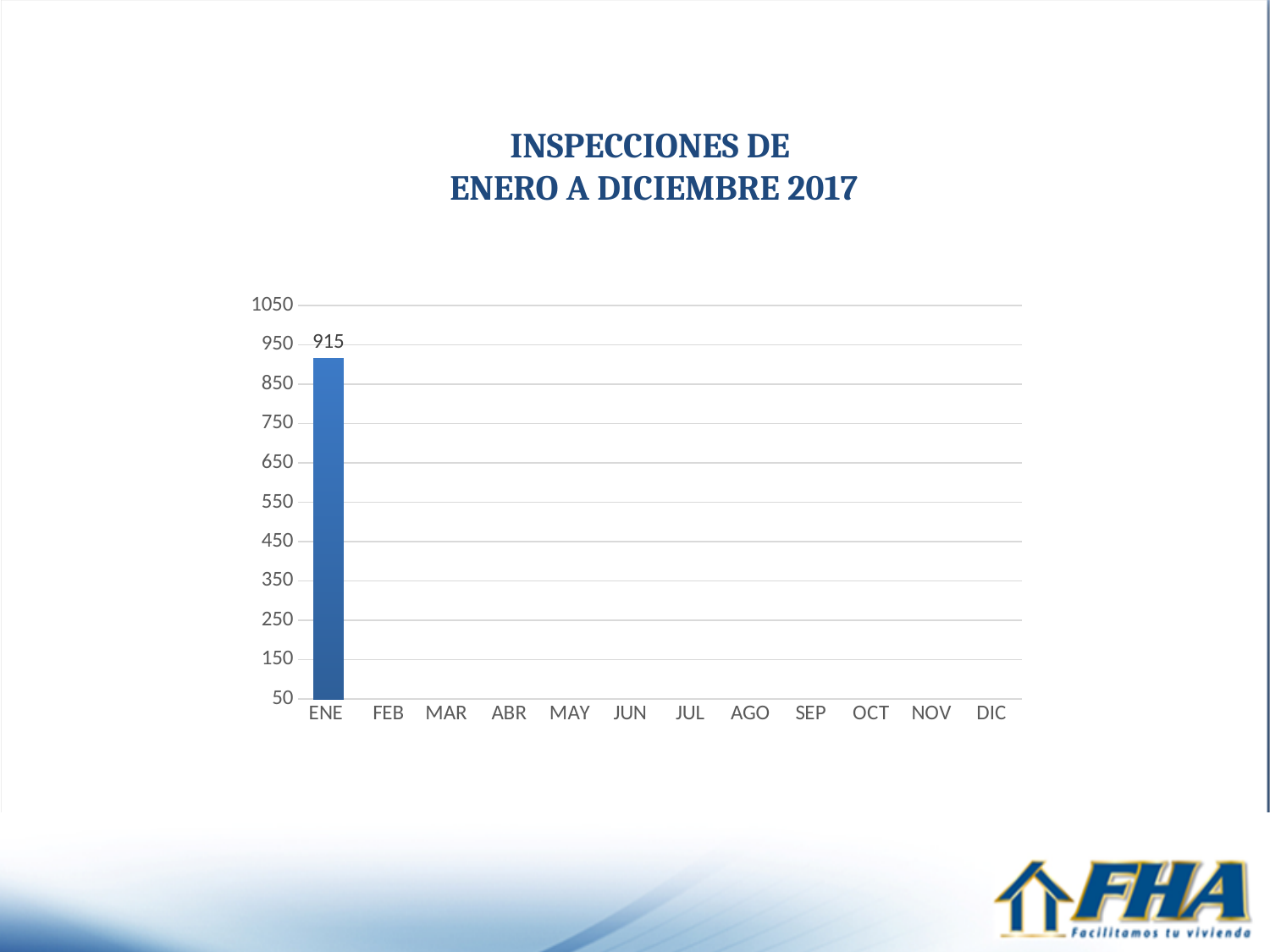
What is the highest value shown on the y axis? 1050 What kind of chart is this? bar chart What is the title of the chart? INSPECCIONES DE ENERO A DICIEMBRE 2017 Which month is the only one with a plotted bar? ENE How many months are shown on the x axis? 12 How many months have a visible bar? 1 Which month has the highest value? ENE Is the value for ENE greater or less than 950? less What is the value for ENE? 915 Is the value for ENE greater or less than 850? greater